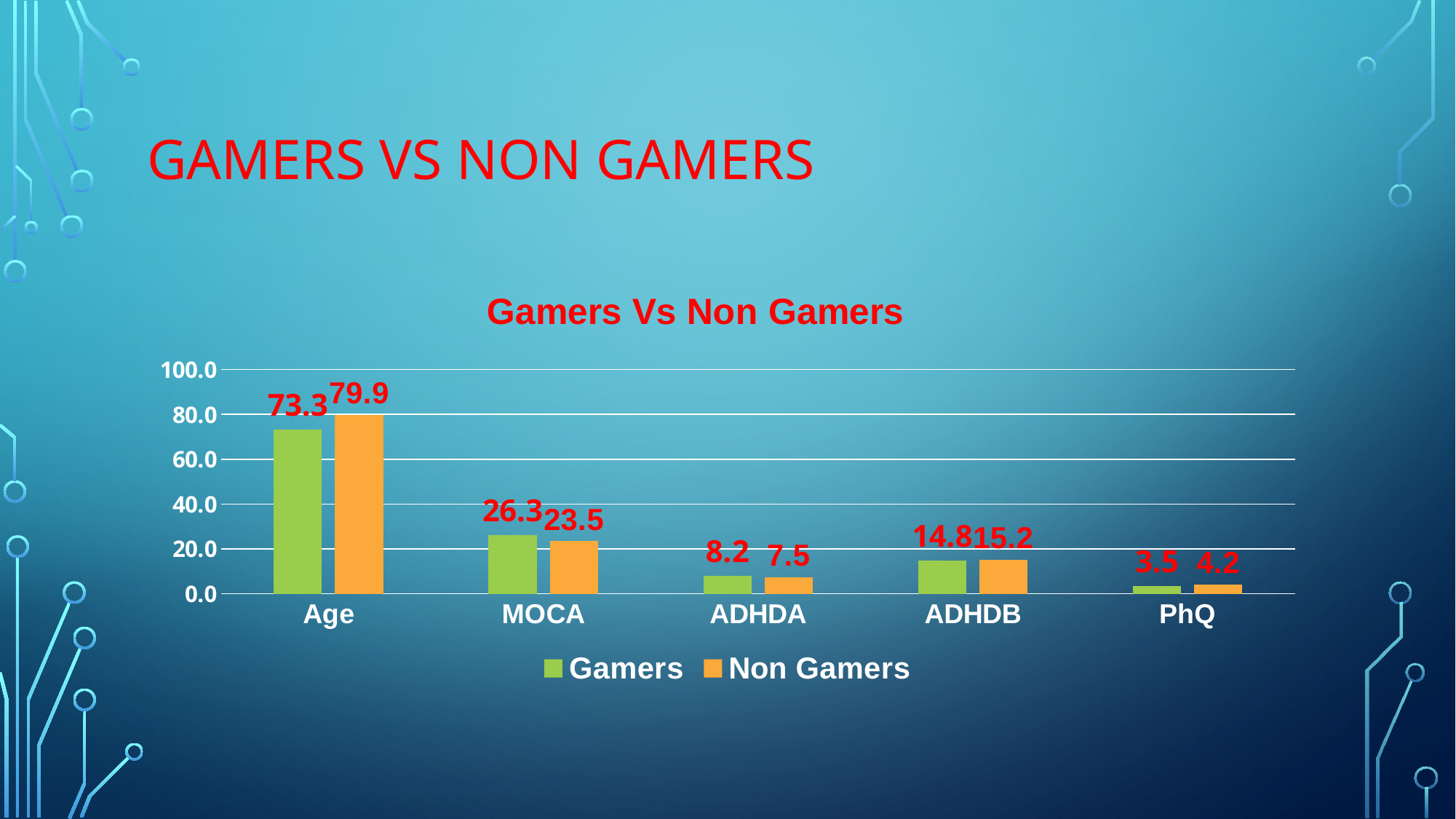
What is the value for Gamers in the PhQ category? 3.5 Is the value for Gamers in the MOCA category greater or less than 20.0? greater What colour represents the Non Gamers series? Orange Which is larger for ADHDA, the Gamers value or the Non Gamers value? Gamers What is the difference between the Non Gamers and Gamers values for Age? 6.6 Which category has the highest value for Non Gamers? Age What is the value for Non Gamers in the MOCA category? 23.5 What is the value for Gamers in the Age category? 73.3 How many categories are shown on the x axis? 5 What kind of chart is shown on the slide? Bar chart Which category has the lowest value for Gamers? PhQ How many series does the legend list? 2